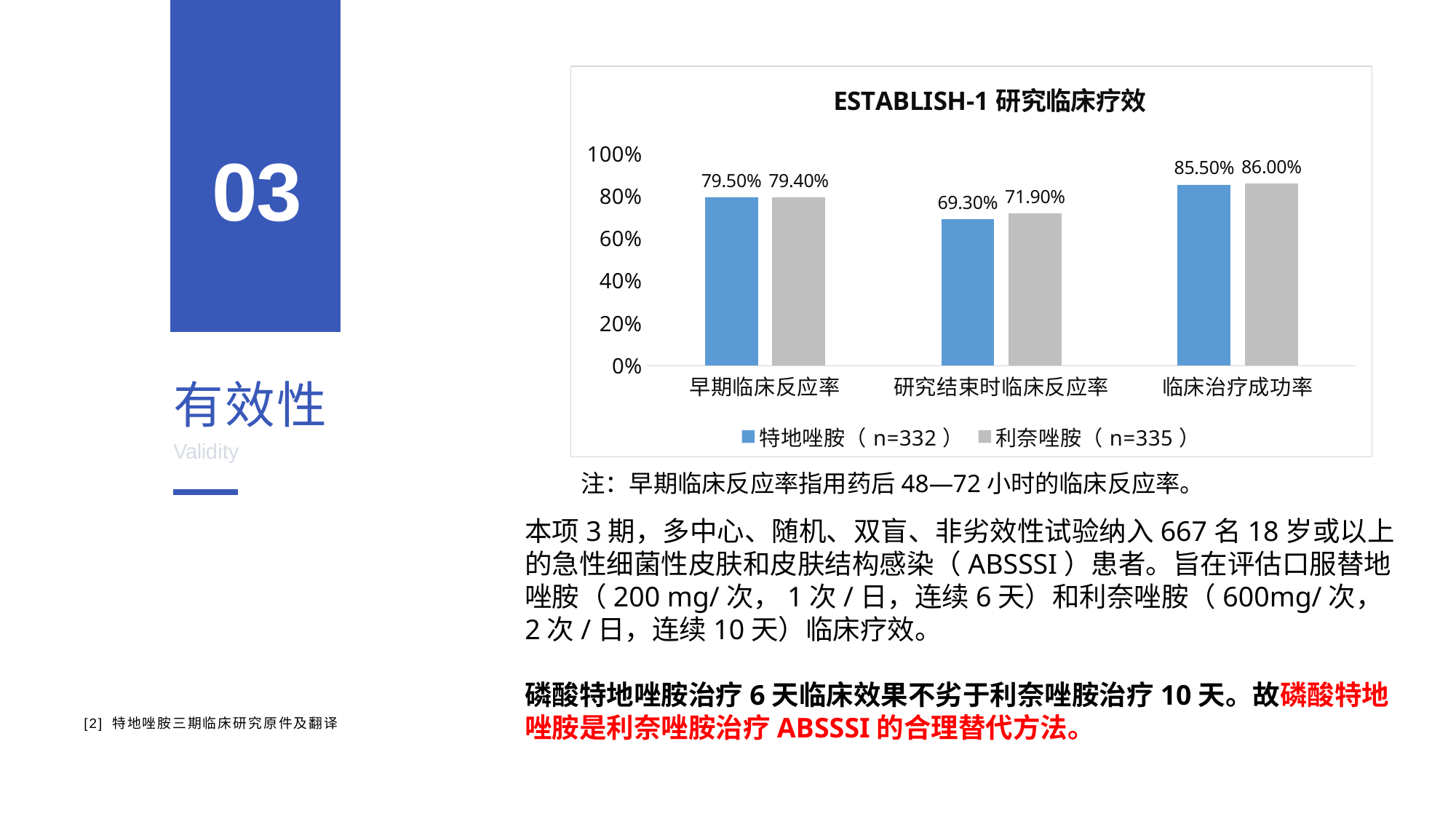
图表中特地唑胺（n=332）在早期临床反应率的数值是多少？ 79.50% 图表的标题是什么？ ESTABLISH-1 研究临床疗效 图表的横轴上共有多少个类别？ 3 图表中利奈唑胺（n=335）在研究结束时临床反应率的数值是多少？ 71.90% 在研究结束时临床反应率中，特地唑胺（n=332）和利奈唑胺（n=335）哪个数值更高？ 利奈唑胺（n=335） 这是什么类型的图表？ 柱状图（条形图） 图表中特地唑胺（n=332）在哪个指标上的数值最高？ 临床治疗成功率 在研究结束时临床反应率中，利奈唑胺（n=335）比特地唑胺（n=332）高多少个百分点？ 2.60% 图表中利奈唑胺（n=335）在哪个指标上的数值最低？ 研究结束时临床反应率 图表的图例中列出了多少个系列？ 2 图表中利奈唑胺（n=335）在临床治疗成功率的数值是多少？ 86.00% 图表中特地唑胺（n=332）的临床治疗成功率是大于还是小于80%？ 大于